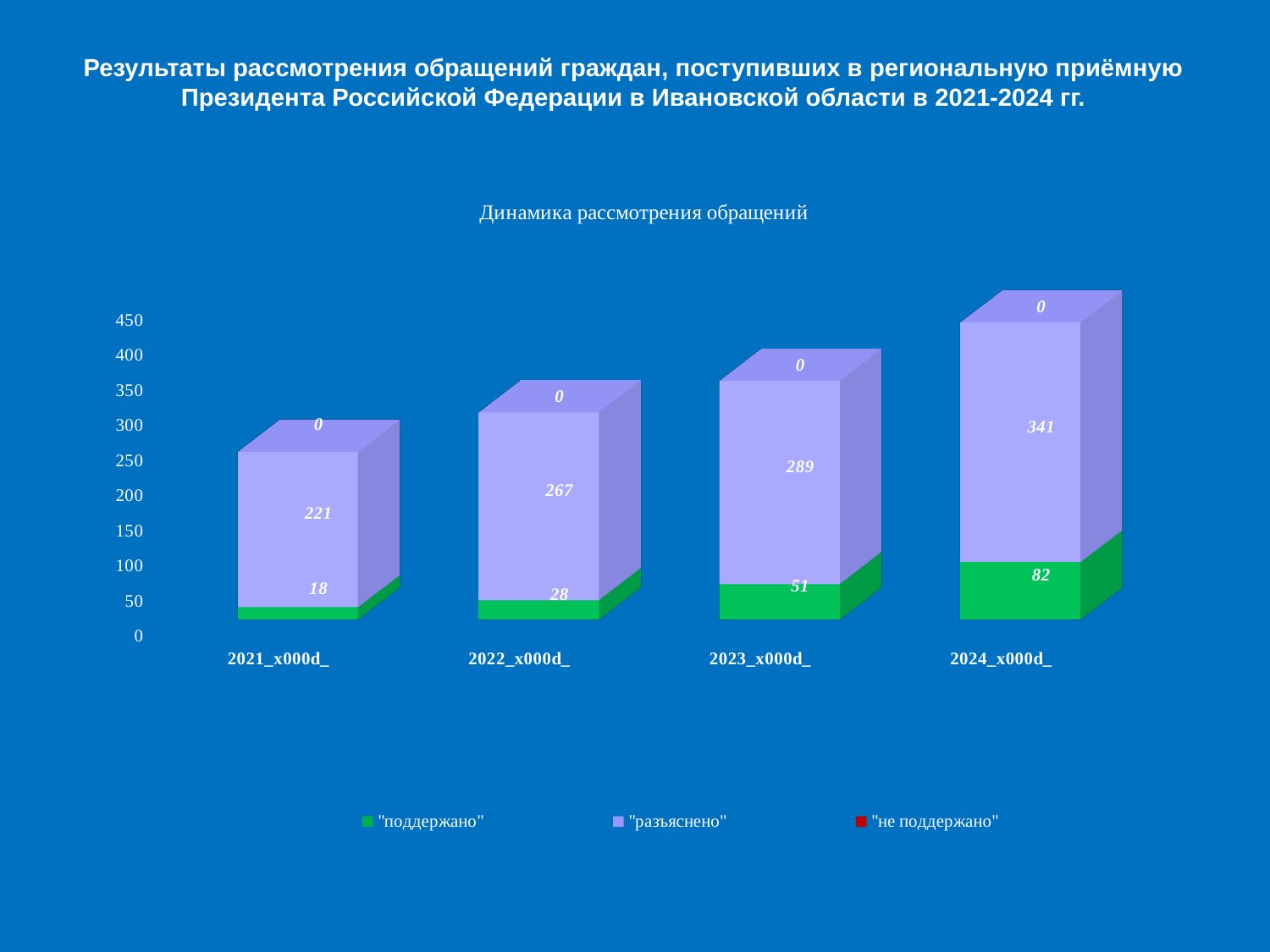
Which is larger: the "поддержано" value for 2023 or for 2022? 2023 In which year is the value for "поддержано" lowest? 2021 How many years (categories) are shown on the x axis? 4 Do the "разъяснено" values rise or fall from 2021 to 2024? Rise What is the value for "поддержано" in 2024? 82 What is the value for "не поддержано" in 2023? 0 What is the value for "разъяснено" in 2022? 267 How many series does the legend list? 3 What is the total of the stacked bar for 2023? 340 What is the difference between the "разъяснено" values for 2024 and 2021? 120 In which year is the value for "разъяснено" highest? 2024 What kind of chart is shown? Stacked bar chart